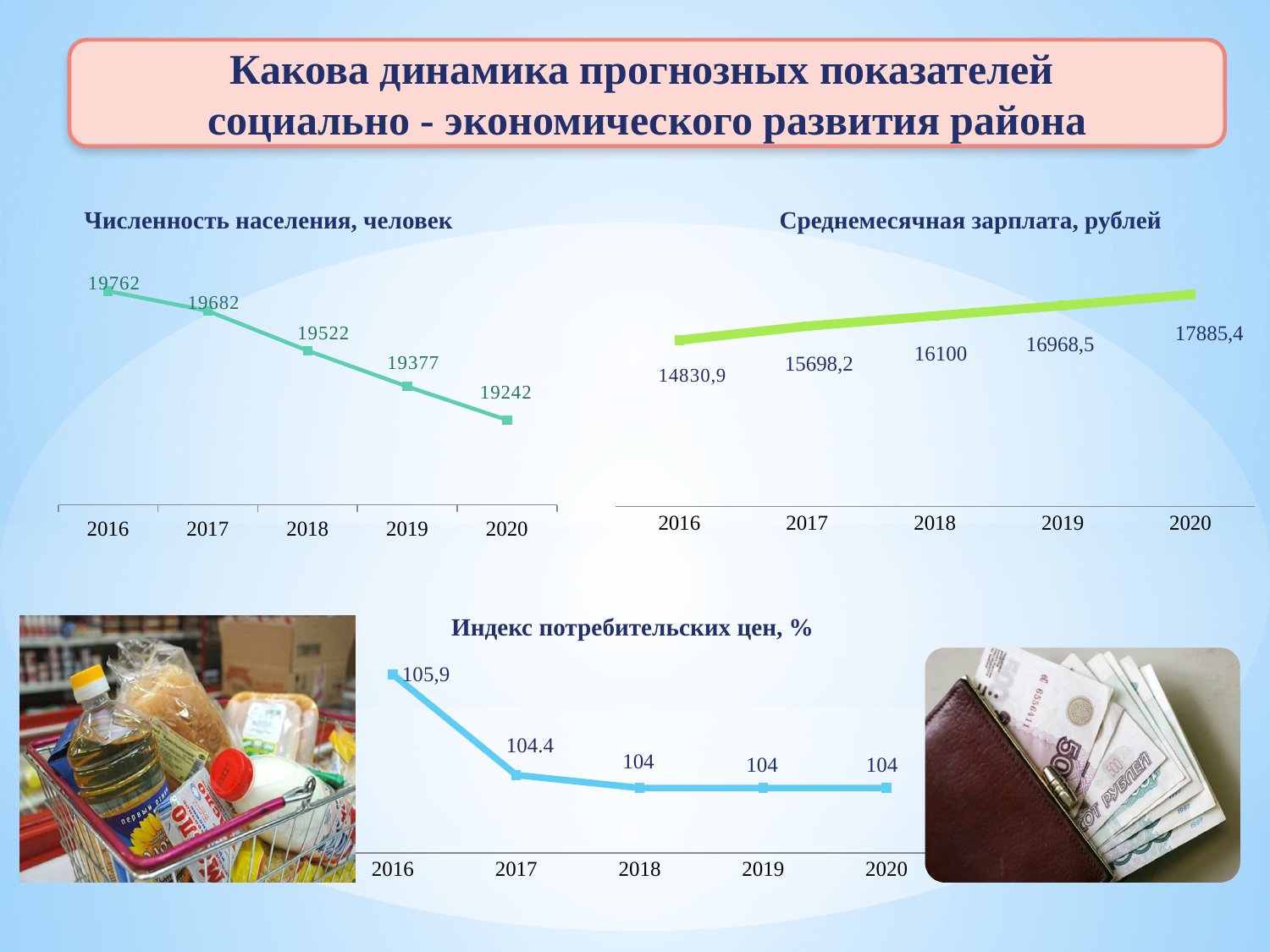
In the chart 'Индекс потребительских цен, %', what is the value for 2016? 105,9 What kind of chart is 'Среднемесячная зарплата, рублей'? line chart In the chart 'Численность населения, человек', which year has the lowest value? 2020 How many years are plotted in the chart 'Индекс потребительских цен, %'? 5 In the chart 'Среднемесячная зарплата, рублей', what is the value for 2019? 16968,5 In the chart 'Среднемесячная зарплата, рублей', by how much does the 2020 value exceed the 2016 value? 3054,5 In the chart 'Среднемесячная зарплата, рублей', which year has the highest value? 2020 In the chart 'Численность населения, человек', what is the value for 2018? 19522 In the chart 'Среднемесячная зарплата, рублей', do the values rise or fall from 2016 to 2020? rise In the chart 'Численность населения, человек', what is the difference between the 2016 and 2020 values? 520 In the chart 'Численность населения, человек', do the values rise or fall from 2016 to 2020? fall In the chart 'Индекс потребительских цен, %', which is larger, the value for 2017 or the value for 2019? 2017